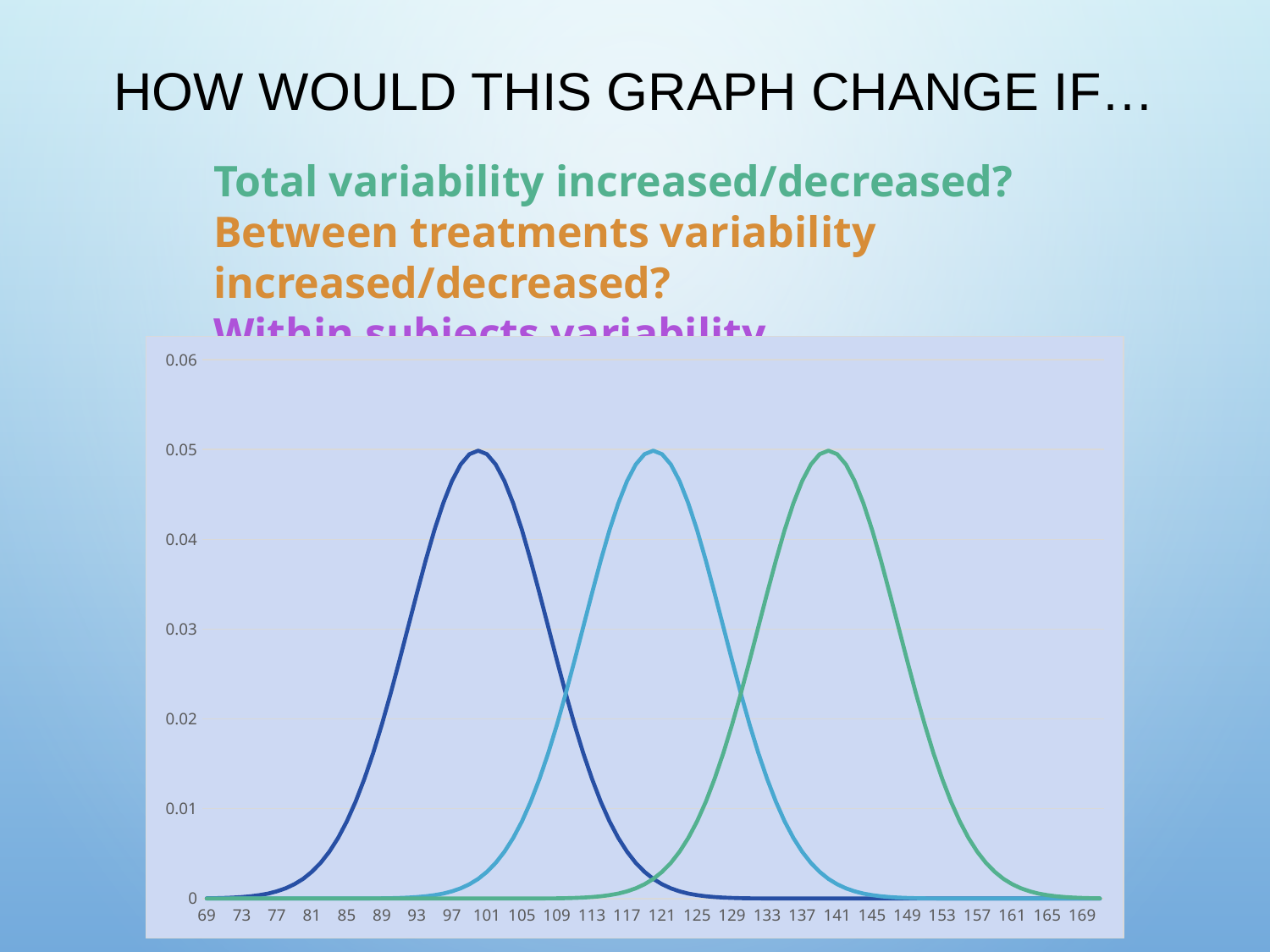
Does the dark blue curve rise or fall between 101 and 129 on the x axis? fall At x = 117, which curve is higher, the dark blue curve or the light blue curve? the light blue curve What kind of chart is shown on the slide? line chart How many tick labels are shown on the x axis of the chart? 26 Is the value of the dark blue curve at 141 greater or less than 0.01? less Which curve reaches its peak furthest to the right on the x axis? the green curve Is the value of the dark blue curve at 101 greater or less than 0.04? greater What is the highest tick label on the y axis of the chart? 0.06 What is the first tick label on the x axis of the chart? 69 Is the value of the green curve at 101 greater or less than 0.01? less How many curves are plotted on the chart? 3